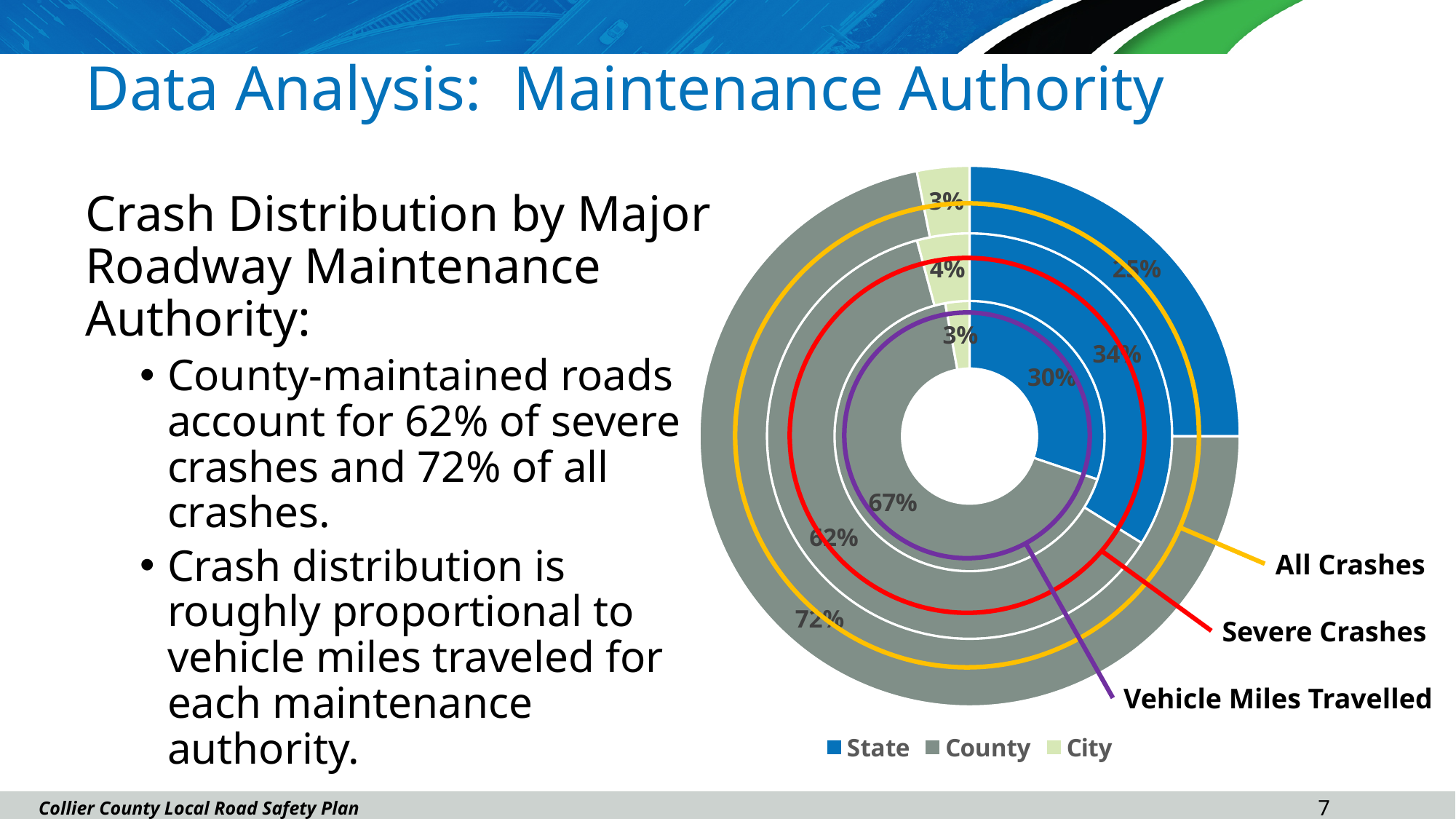
What share of Severe Crashes is on State-maintained roads? 34% What is the difference between the County share of All Crashes and the County share of Severe Crashes? 10% What share of All Crashes is on County-maintained roads? 72% What share of Vehicle Miles Travelled is on County-maintained roads? 67% What type of chart is shown on the slide? Doughnut chart How many categories does the legend of the chart list? 3 Is the State share larger for Severe Crashes or for All Crashes? Severe Crashes Which maintenance authority has the largest share of Severe Crashes? County Which ring of the chart is outlined in red? Severe Crashes What share of All Crashes is on State-maintained roads? 25% What share of Severe Crashes is on City-maintained roads? 4% Which maintenance authority has the smallest share of Vehicle Miles Travelled? City